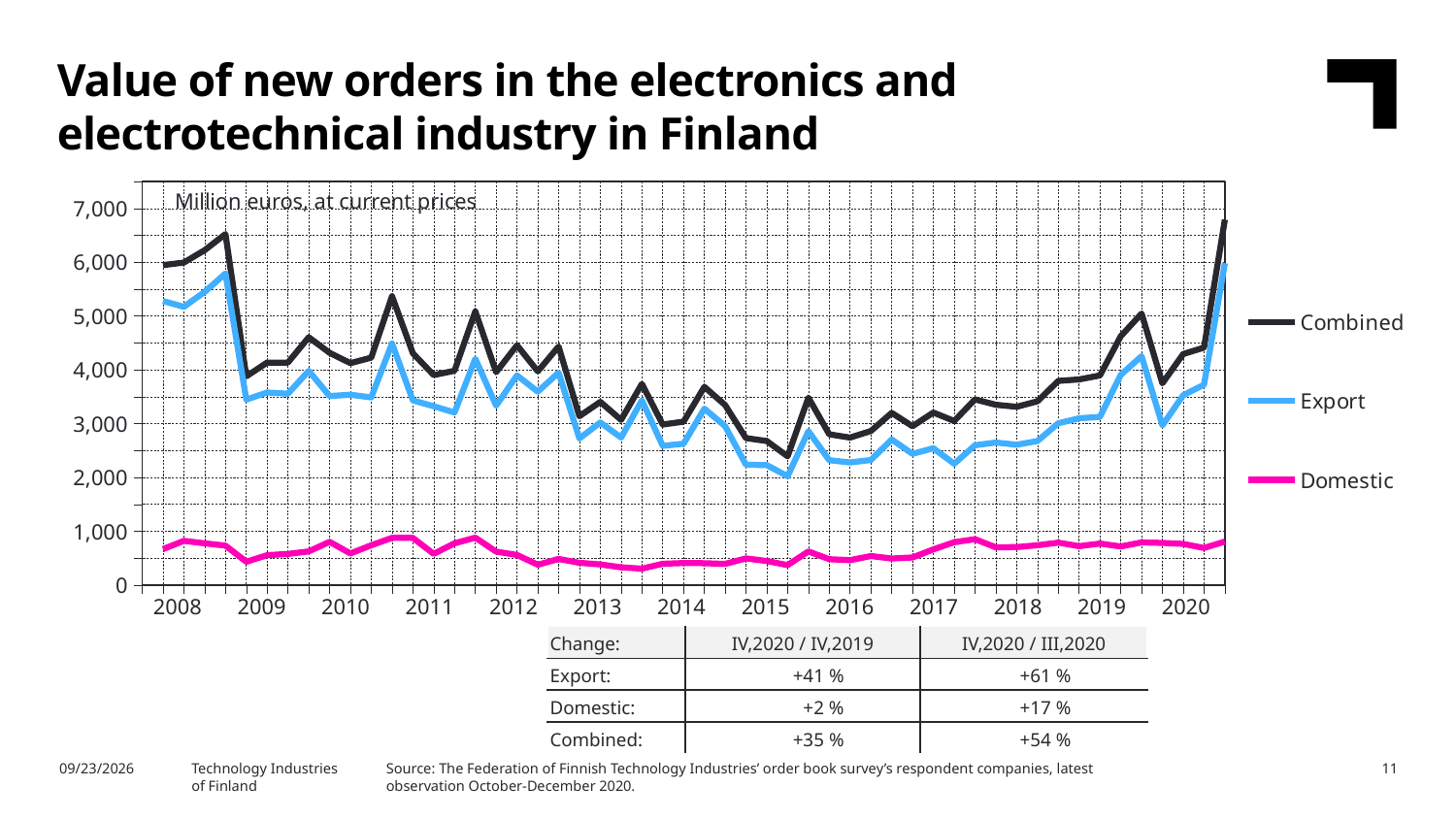
What unit does the chart's subtitle say the values are in? Million euros, at current prices Is the Export value in 2016 greater or less than 4,000? less In 2010, which is larger, the Combined value or the Domestic value? Combined How many years are labelled on the x axis? 13 Is the Export value at the end of 2020 greater or less than 5,000? greater Which series has the highest values throughout the chart? Combined How many series does the legend list? 3 Is the Combined value at the start of 2008 greater or less than 5,000? greater What kind of chart is shown on the slide? Line chart Which series has the lowest values throughout the chart? Domestic Does the Combined series rise or fall from 2008 to 2009? Fall